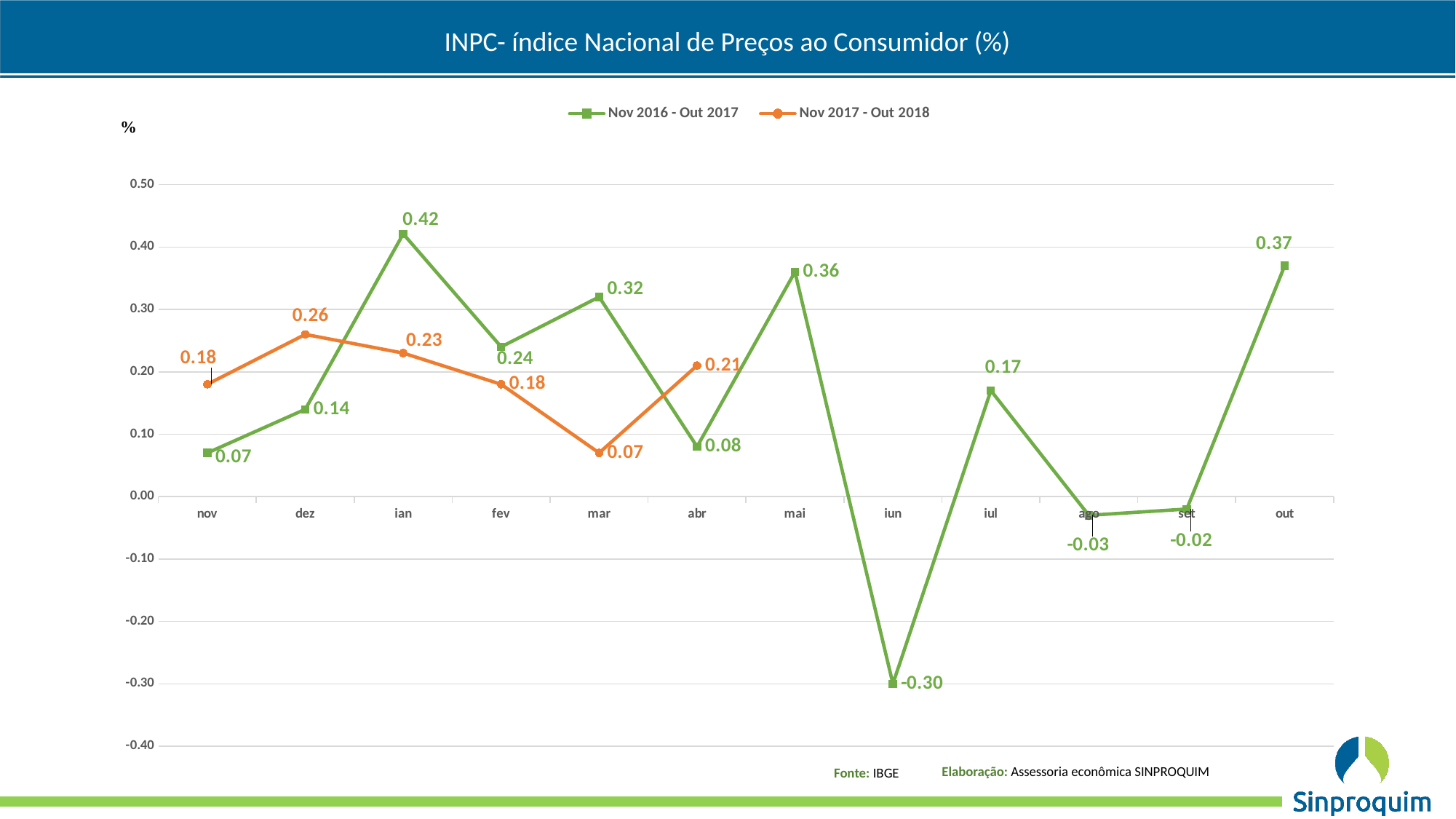
What is the difference between the Nov 2016 - Out 2017 and Nov 2017 - Out 2018 values for nov? 0.11 Does the Nov 2017 - Out 2018 series rise or fall from dez to mar? fall What is the title of the chart? INPC- índice Nacional de Preços ao Consumidor (%) What type of chart is shown on the slide? line chart Which month has the lowest value in the Nov 2016 - Out 2017 series? jun What is the value for jun in the Nov 2016 - Out 2017 series? -0.30 How many series does the legend list? 2 What is the value for dez in the Nov 2017 - Out 2018 series? 0.26 What is the value for jan in the Nov 2016 - Out 2017 series? 0.42 Which month has the highest value in the Nov 2017 - Out 2018 series? dez Which series has the larger value for mar, Nov 2016 - Out 2017 or Nov 2017 - Out 2018? Nov 2016 - Out 2017 How many months are plotted for the Nov 2017 - Out 2018 series? 6